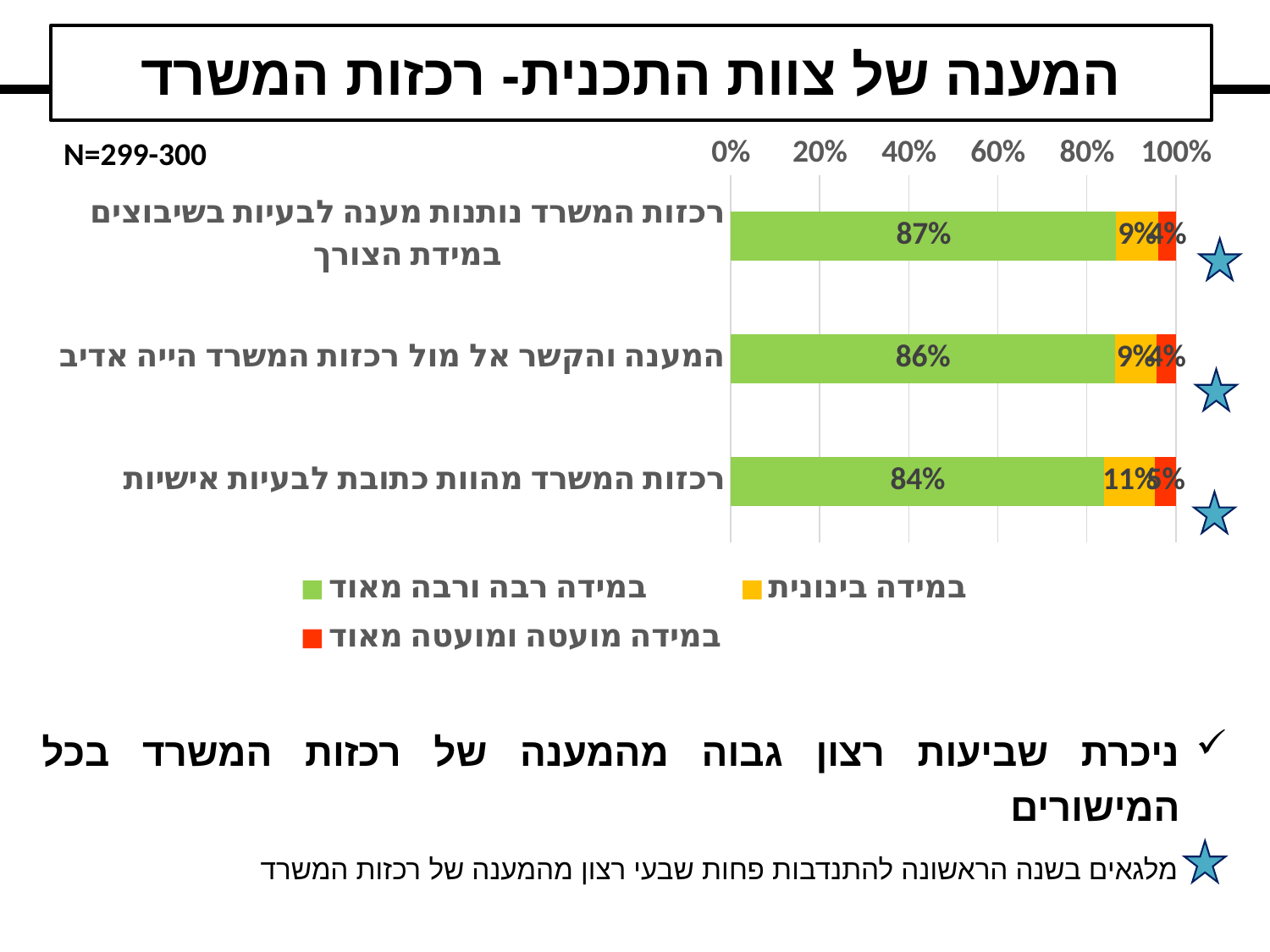
What is the value of the green series (במידה רבה ורבה מאוד) for 'רכזות המשרד נותנות מענה לבעיות בשיבוצים במידת הצורך'? 87% How many categories (statements) are plotted in the chart? 3 How many series does the legend list? 3 What is the value of the yellow series (במידה בינונית) for 'רכזות המשרד מהוות כתובת לבעיות אישיות'? 11% Is the green-series value for 'המענה והקשר אל מול רכזות המשרד הייה אדיב' greater or less than 80%? greater What kind of chart is shown on the slide? Stacked bar chart What sample size (N) is stated on the slide for the chart? N=299-300 What is the difference between the green-series values for 'רכזות המשרד נותנות מענה לבעיות בשיבוצים במידת הצורך' and 'רכזות המשרד מהוות כתובת לבעיות אישיות'? 3% Which statement has the highest value for the green series (במידה רבה ורבה מאוד)? רכזות המשרד נותנות מענה לבעיות בשיבוצים במידת הצורך Which statement has the lowest value for the green series (במידה רבה ורבה מאוד)? רכזות המשרד מהוות כתובת לבעיות אישיות What is the value of the green series (במידה רבה ורבה מאוד) for 'המענה והקשר אל מול רכזות המשרד הייה אדיב'? 86% What is the value of the green series (במידה רבה ורבה מאוד) for 'רכזות המשרד מהוות כתובת לבעיות אישיות'? 84%